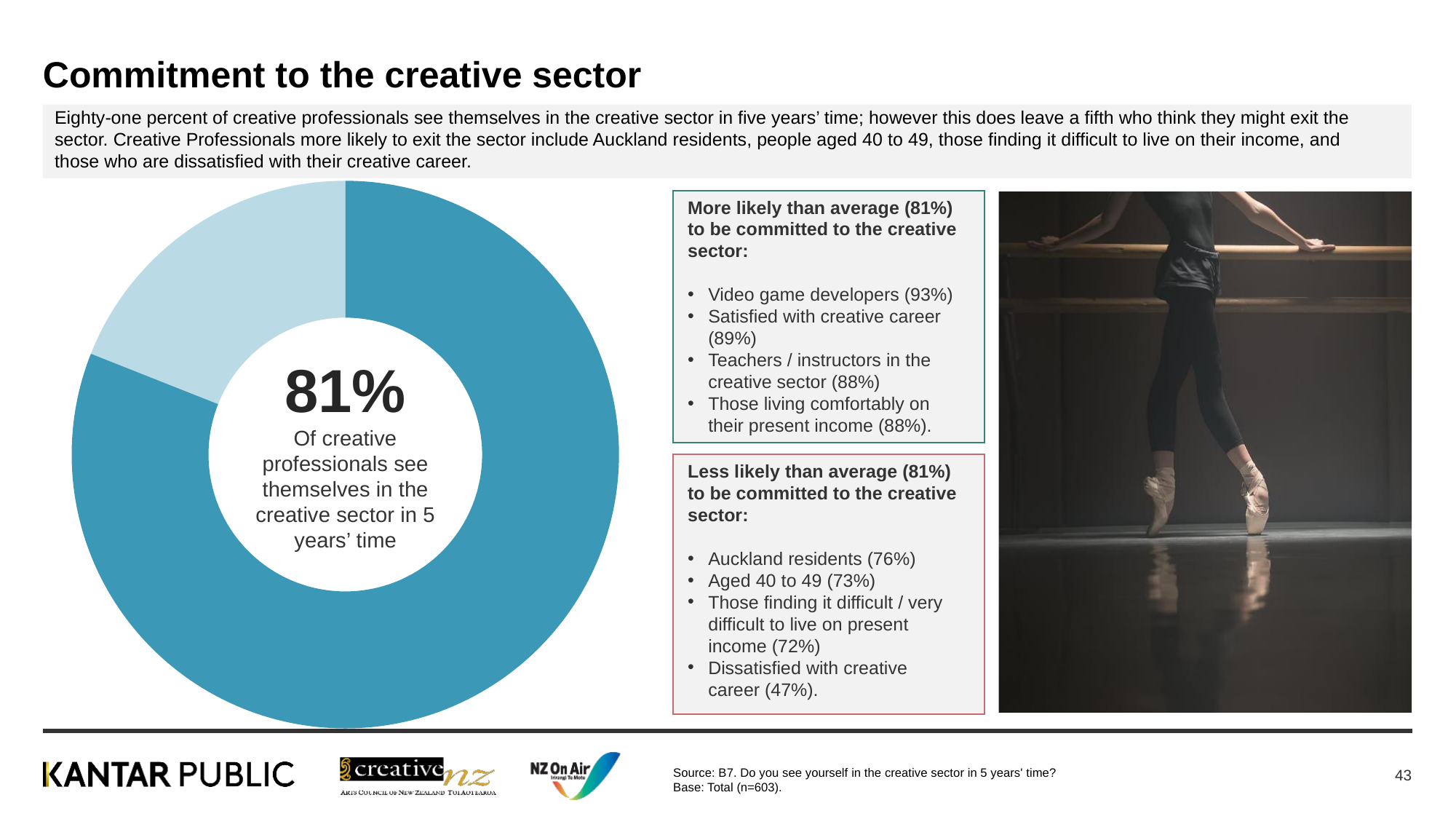
What percentage is printed in the centre of the donut chart? 81% According to the donut chart, what share of creative professionals see themselves in the creative sector in 5 years' time? 81% What colour is the largest slice of the donut chart? Dark blue Is the dark blue slice of the donut chart larger or smaller than the light blue slice? Larger Is the share represented by the dark blue slice greater or less than 50%? greater What does the text in the centre of the donut chart say the 81% refers to? Of creative professionals see themselves in the creative sector in 5 years' time Which slice of the donut chart is the largest? The dark blue slice (81%) How many slices does the donut chart have? 2 What kind of chart is shown on the left of the slide? Pie chart (donut)